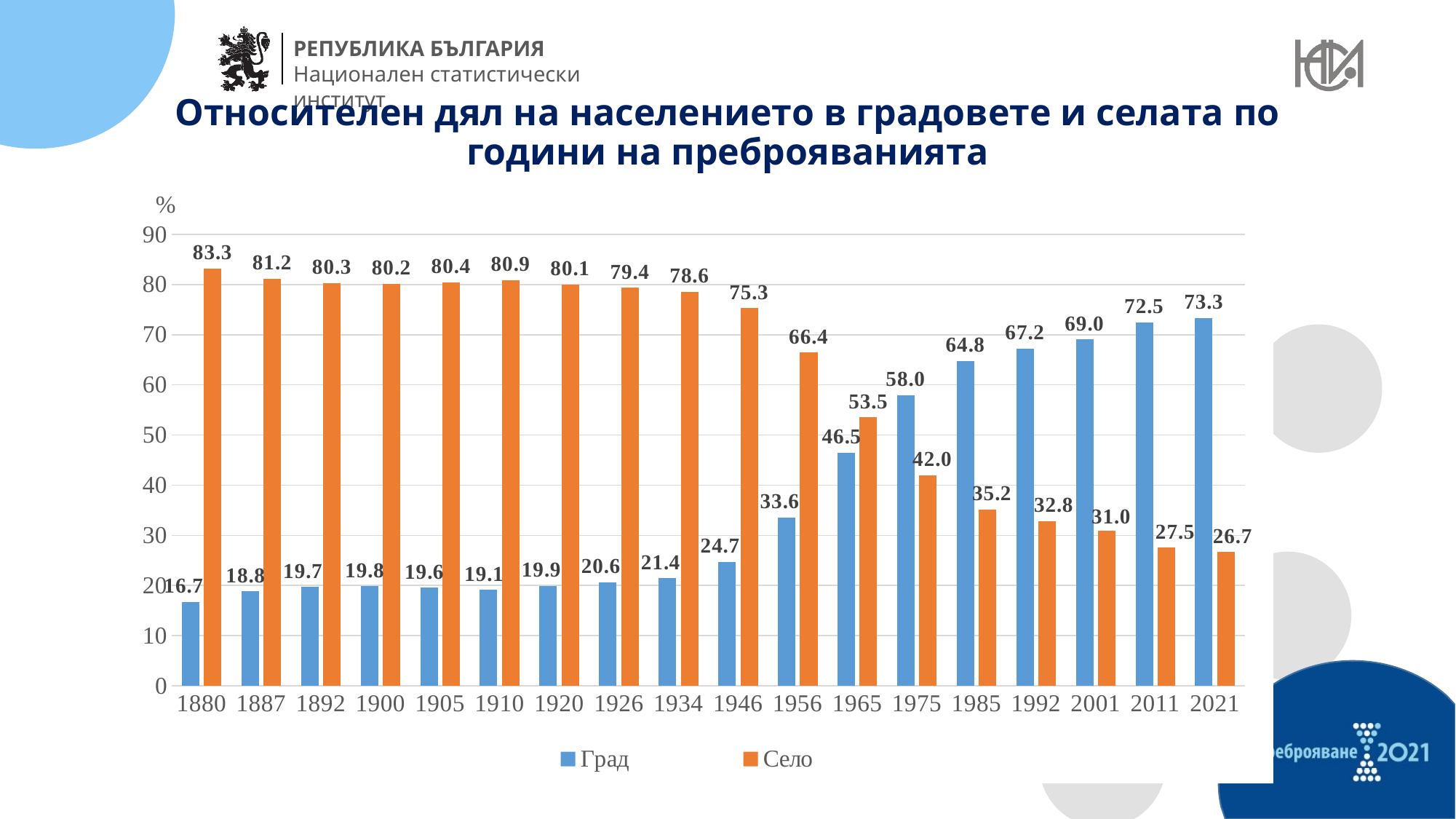
How many census years are shown on the x axis? 18 In which year is the Село series at its highest? 1880 What is the value for Село in 1880? 83.3 What kind of chart is shown on the slide? bar chart In 1956, which series has the larger value, Град or Село? Село What is the total of the Град and Село values in 2011? 100.0 Does the Град series generally rise or fall from 1880 to 2021? rise In which year is the Град series at its lowest? 1880 What is the value for Град in 2021? 73.3 How many series does the legend list? 2 What is the value for Град in 1965? 46.5 What is the difference between the Село and Град values in 1975? 16.0